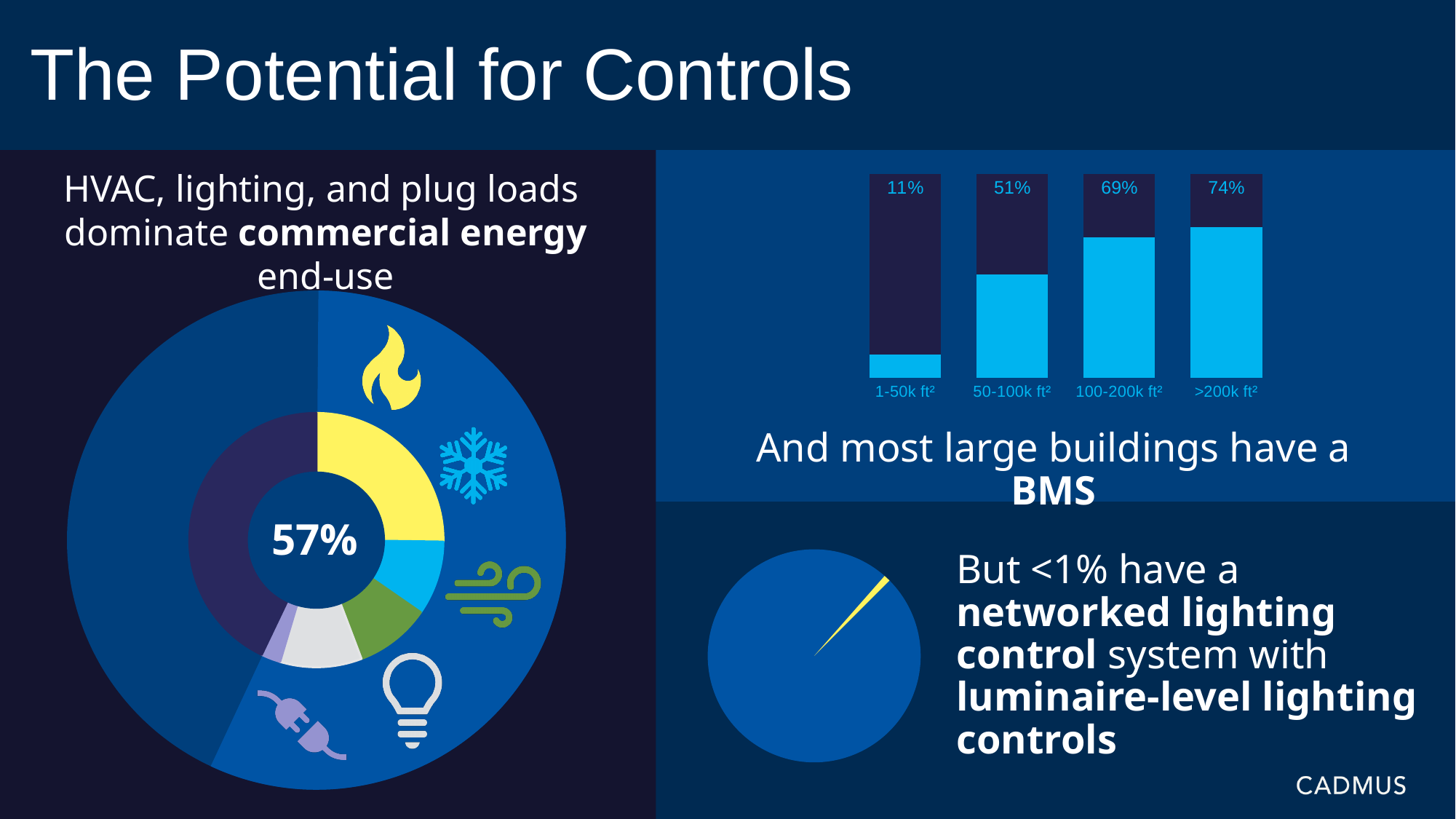
In the bar chart at the top right, which building size category has the lowest value? 1-50k ft² In the bar chart at the top right, do the values rise or fall as building size increases along the x axis? Rise In the bar chart at the top right, which is larger: the value for 50-100k ft² or the value for 100-200k ft²? 100-200k ft² In the bar chart at the top right, what is the value for >200k ft²? 74% In the bar chart at the top right, what is the value for 1-50k ft²? 11% In the bar chart at the top right, what is the difference between the values for >200k ft² and 1-50k ft²? 63 percentage points What kind of chart is shown at the top right of the slide? Bar chart In the bar chart at the top right, which building size category has the highest value? >200k ft² In the bar chart at the top right, what is the value for 100-200k ft²? 69% How many building size categories are shown in the bar chart at the top right? 4 What value is printed in the centre of the donut chart on the left of the slide? 57% In the bar chart at the top right, what is the value for 50-100k ft²? 51%